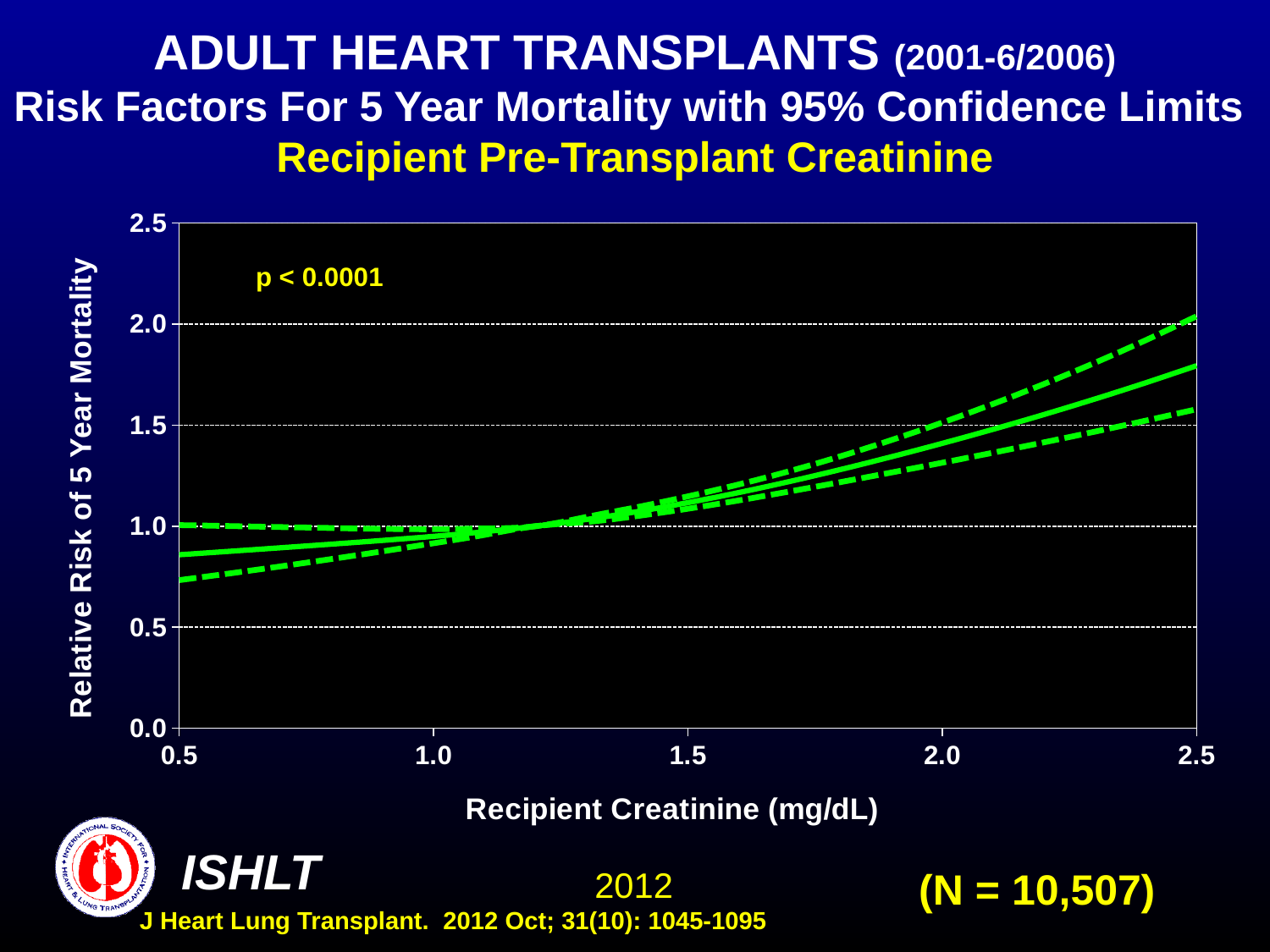
Is the relative risk of 5 year mortality (solid line) at a recipient creatinine of 0.5 mg/dL greater or less than 1.0? less What p-value is shown on the chart? p < 0.0001 Does the relative risk of 5 year mortality rise or fall as recipient creatinine increases from 0.5 to 2.5 mg/dL? rise Is the relative risk of 5 year mortality (solid line) at a recipient creatinine of 2.5 mg/dL greater or less than 1.5? greater Is the relative risk of 5 year mortality (solid line) at a recipient creatinine of 2.0 mg/dL greater or less than 2.0? less How many lines are plotted on the chart? 3 What kind of chart is shown on the slide? line chart What is the highest value shown on the y axis? 2.5 What is the label of the x axis? Recipient Creatinine (mg/dL)